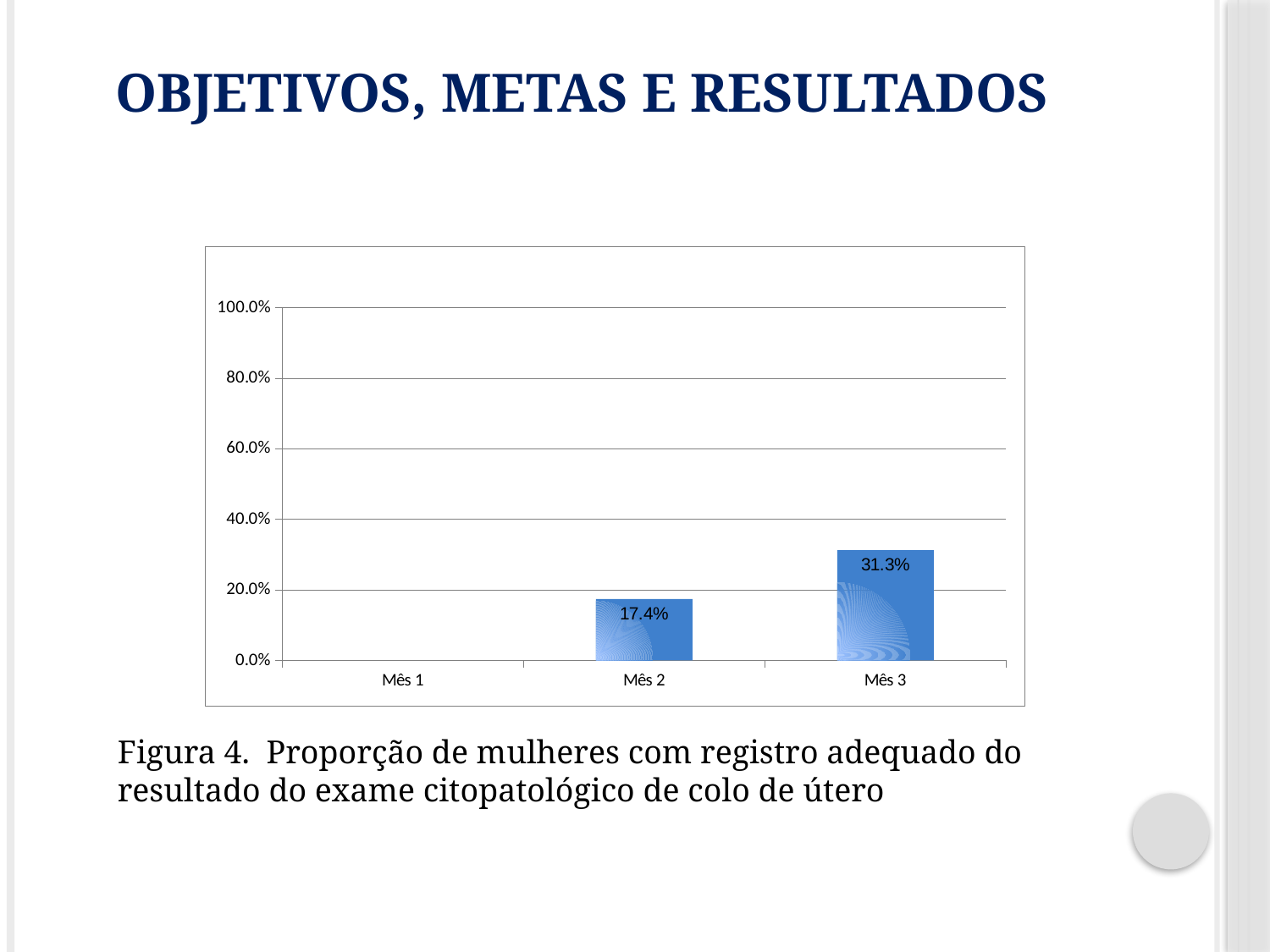
Which month has the highest value? Mês 3 Do the values rise or fall from Mês 1 to Mês 3? rise Is the value for Mês 2 greater or less than 20.0%? less What is the difference between the values for Mês 3 and Mês 2? 13.9% What is the highest value shown on the y axis? 100.0% Which is larger, the value for Mês 2 or the value for Mês 3? Mês 3 What is the value for Mês 2? 17.4% Is the value for Mês 3 greater or less than 40.0%? less Which month has no bar shown in the chart? Mês 1 How many months are shown on the x axis? 3 What is the value for Mês 3? 31.3% What kind of chart is shown on the slide? bar chart